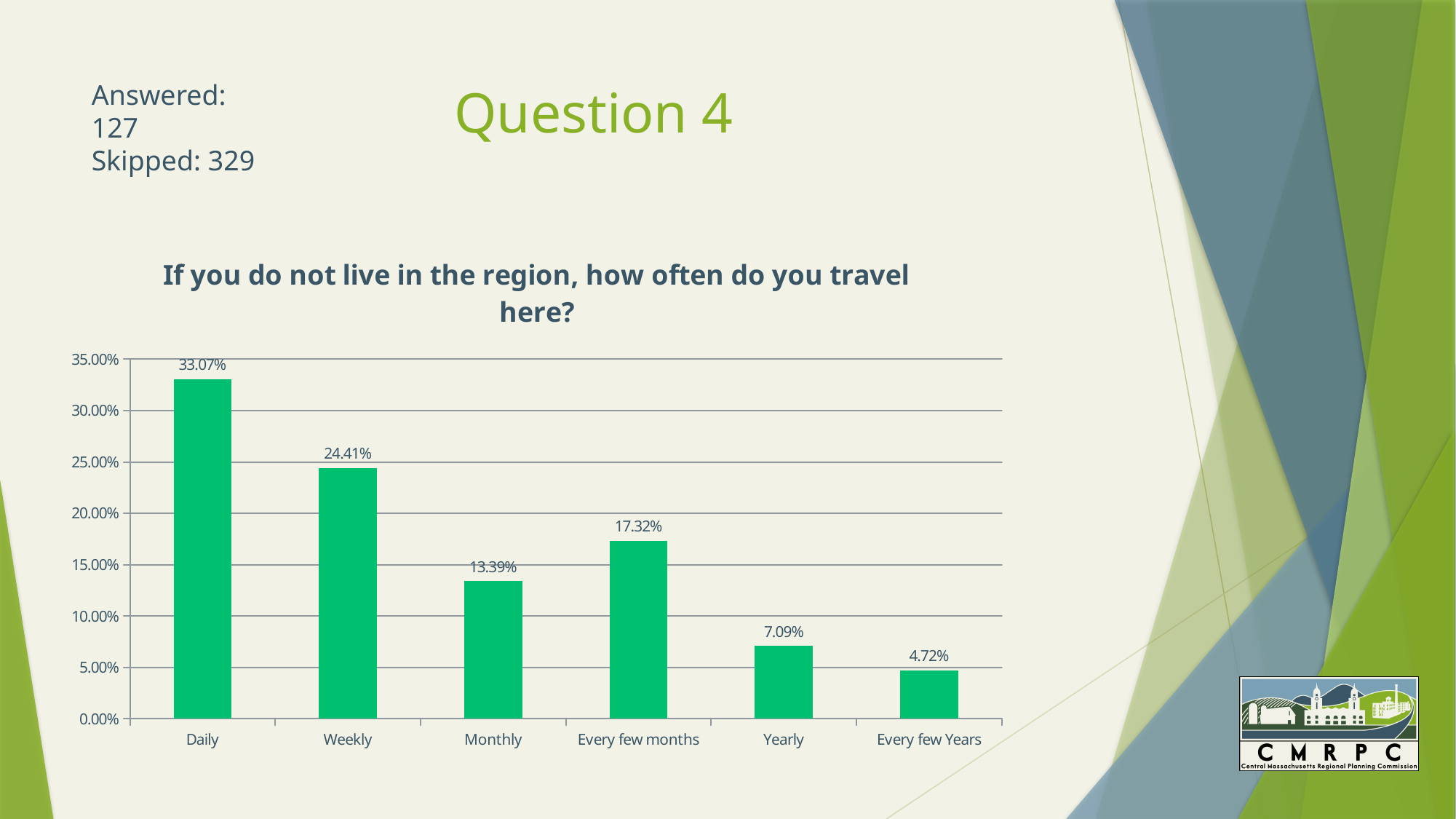
What percentage of respondents travel to the region daily? 33.07% Which category has the highest value? Daily Which category has the lowest value? Every few Years What kind of chart is shown on the slide? Bar chart Which is larger, the value for Monthly or the value for Every few months? Every few months What is the difference between the Every few months and Monthly values? 3.93% What is the difference between the Daily and Weekly values? 8.66% What is the value for Every few Years? 4.72% What is the title of the chart? If you do not live in the region, how often do you travel here? What percentage is shown for Every few months? 17.32% How many categories are shown on the x axis? 6 What is the value shown for the Weekly category? 24.41%